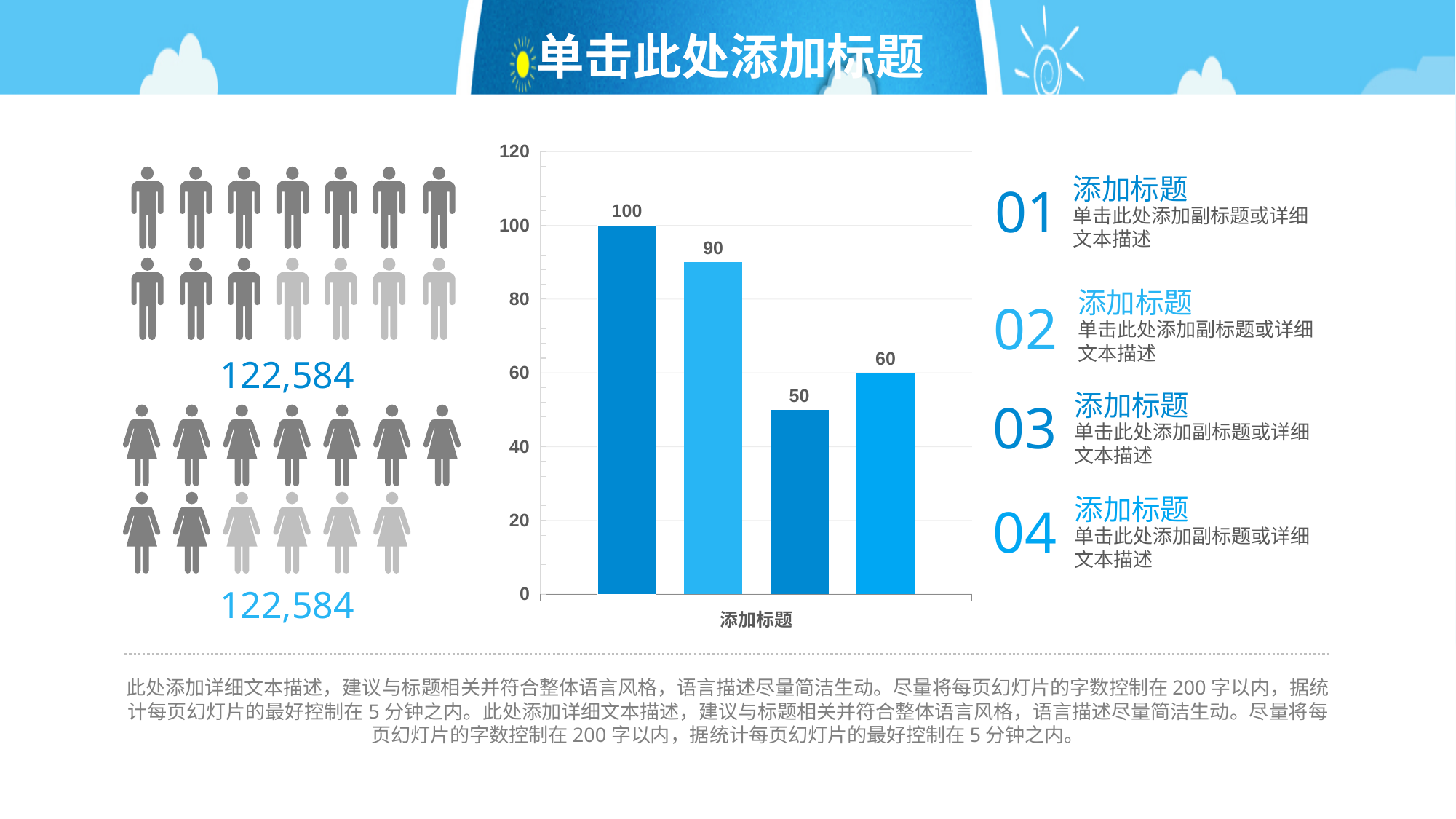
Which bar in the bar chart has the lowest value? the third bar, 50 What is the difference between the first bar (100) and the third bar (50) in the bar chart? 50 What is the label shown on the horizontal axis of the bar chart? 添加标题 What is the value of the fourth (rightmost) bar in the bar chart? 60 What is the value of the first (leftmost) bar in the bar chart? 100 Which bar in the bar chart has the highest value? the first (leftmost) bar, 100 In the bar chart, which is larger: the second bar or the fourth bar? the second bar (90) How many bars are plotted in the bar chart? 4 What is the value of the second bar from the left in the bar chart? 90 What is the value of the third bar from the left in the bar chart? 50 What is the maximum value shown on the vertical axis of the bar chart? 120 What kind of chart is shown in the middle of the slide? bar chart